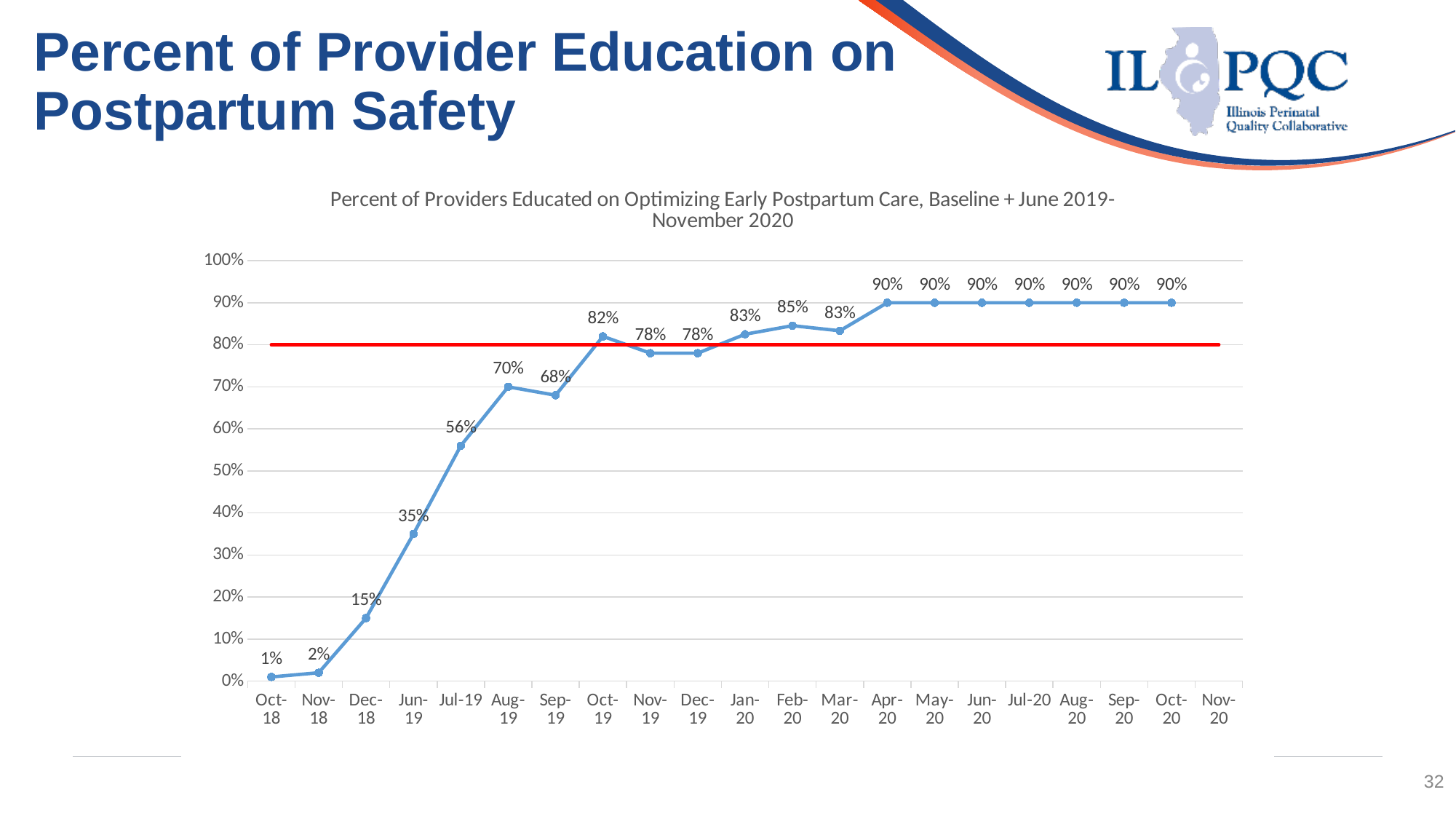
What is the value for Oct-19? 82% Do the values generally rise or fall from Oct-18 to Apr-20? Rise What is the difference between the values for Aug-19 and Sep-19? 2% Which month has the lowest value? Oct-18 What is the highest value plotted on the chart? 90% What kind of chart is shown on the slide? Line chart How many months show a value of 90%? 7 What is the value for Feb-20? 85% At what percentage is the horizontal red line drawn? 80% What is the difference between the values for Jun-19 and Dec-18? 20% What is the value for Jul-19? 56% Which is larger, the value for Nov-19 or the value for Jan-20? Jan-20